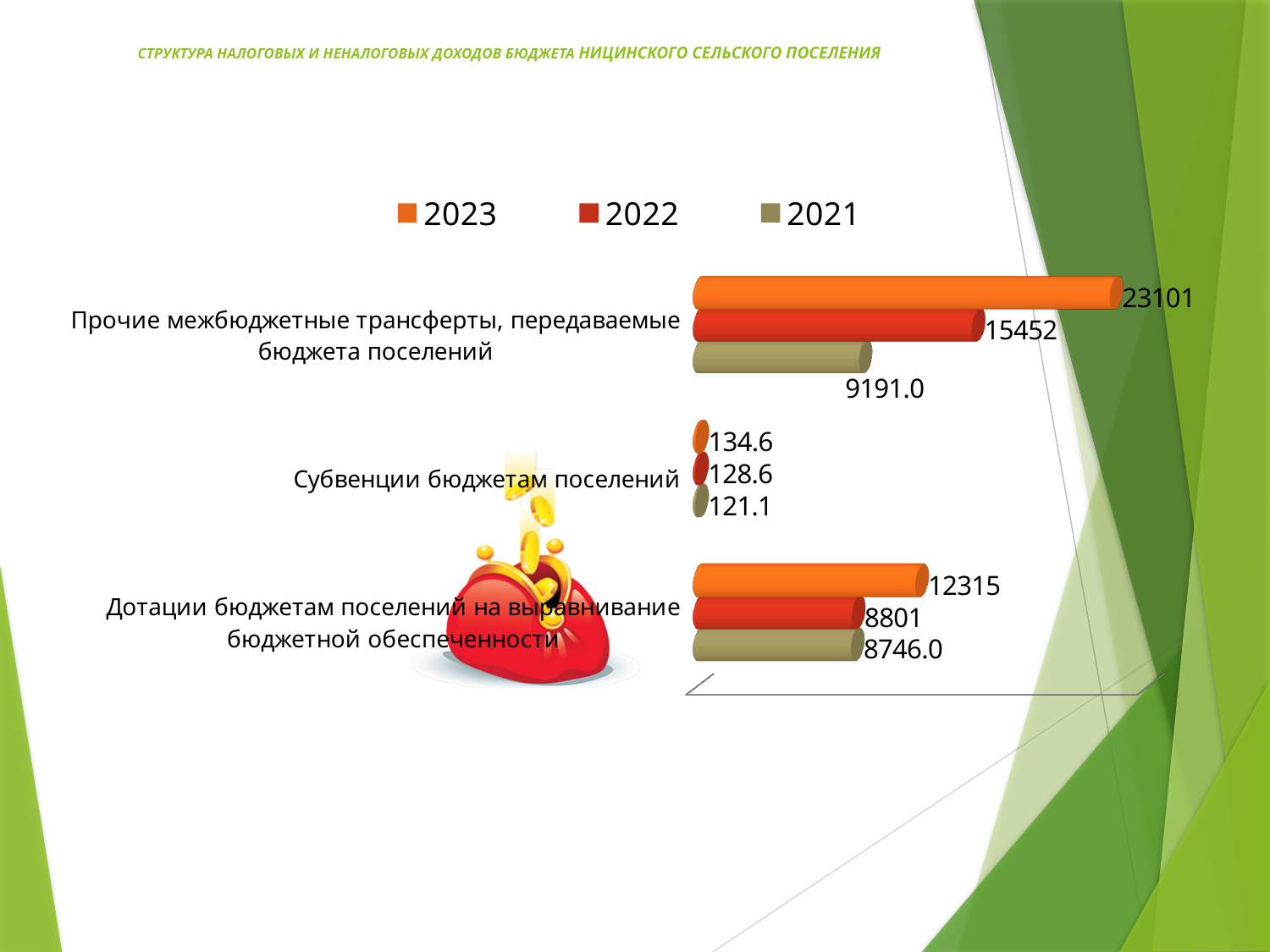
Which is larger for «Дотации бюджетам поселений на выравнивание бюджетной обеспеченности»: the 2023 value or the 2021 value? 2023 Which category has the highest 2023 value? Прочие межбюджетные трансферты, передаваемые бюджета поселений What kind of chart is shown on the slide? Bar chart What is the 2021 value for «Субвенции бюджетам поселений»? 121.1 What is the 2023 value for «Прочие межбюджетные трансферты, передаваемые бюджета поселений»? 23101 What is the 2022 value for «Дотации бюджетам поселений на выравнивание бюджетной обеспеченности»? 8801 What is the 2021 value for «Прочие межбюджетные трансферты, передаваемые бюджета поселений»? 9191.0 Which category has the lowest 2022 value? Субвенции бюджетам поселений How many categories are shown on the chart? 3 How many series does the legend list? 3 What is the difference between the 2023 and 2022 values for «Прочие межбюджетные трансферты, передаваемые бюджета поселений»? 7649 What is the difference between the 2023 and 2021 values for «Субвенции бюджетам поселений»? 13.5